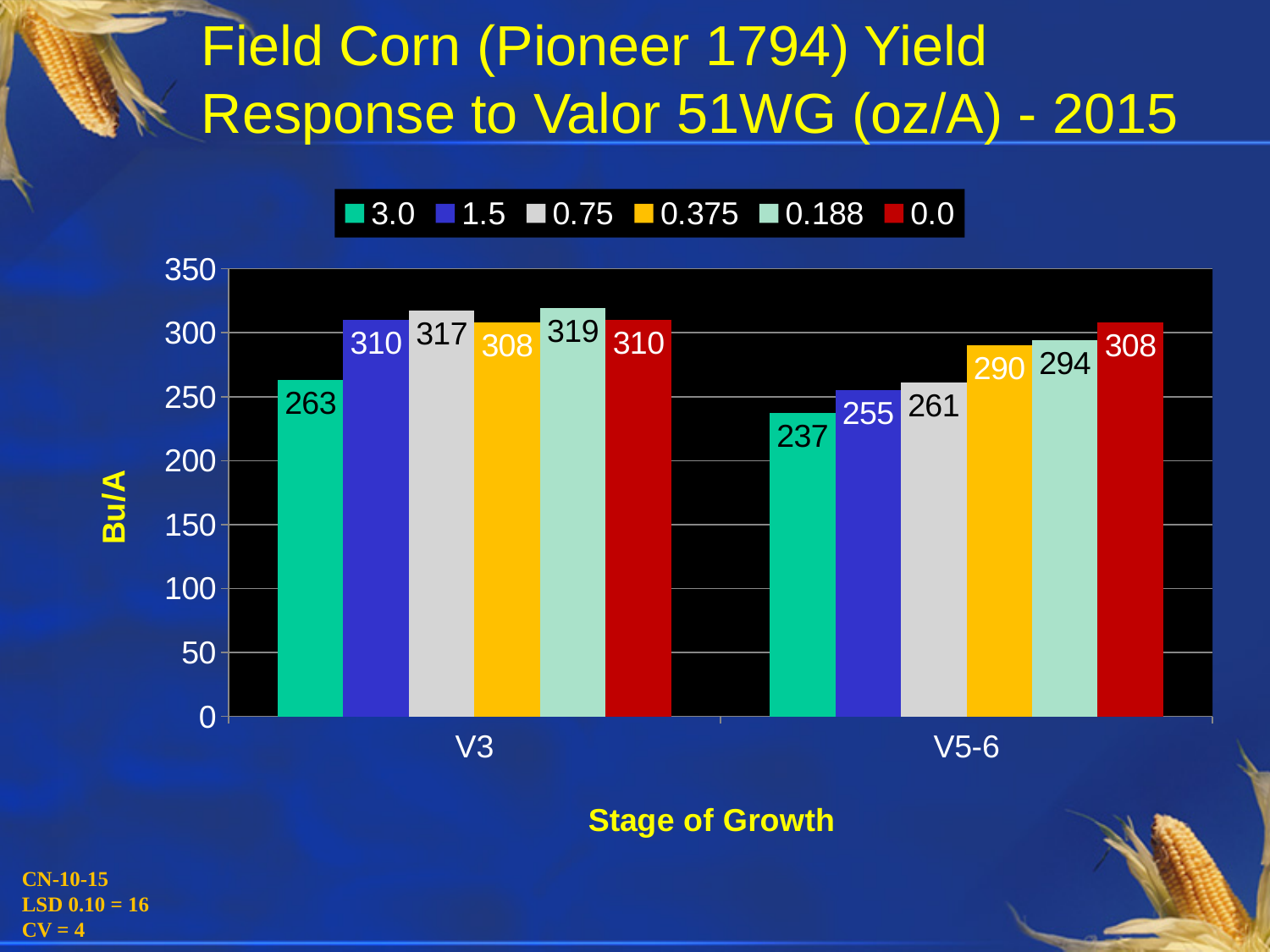
How many series does the legend list? 6 Which rate has the lowest yield at the V5-6 stage? 3.0 Which rate has the highest yield at the V3 stage? 0.188 What type of chart is shown on the slide? bar chart What is the yield (Bu/A) for the 0.0 oz/A rate at the V5-6 stage? 308 What is the difference in yield for the 3.0 rate between the V3 and V5-6 stages? 26 What is the yield (Bu/A) for the 0.375 oz/A rate at the V5-6 stage? 290 What is the difference in yield between the 0.188 rate and the 3.0 rate at the V3 stage? 56 Is the yield for the 0.75 rate at the V5-6 stage greater or less than 300? less How many stage-of-growth categories are shown on the x axis? 2 What is the yield (Bu/A) for the 3.0 oz/A rate at the V3 stage? 263 Which is larger: the yield for the 1.5 rate at V3 or the yield for the 1.5 rate at V5-6? V3